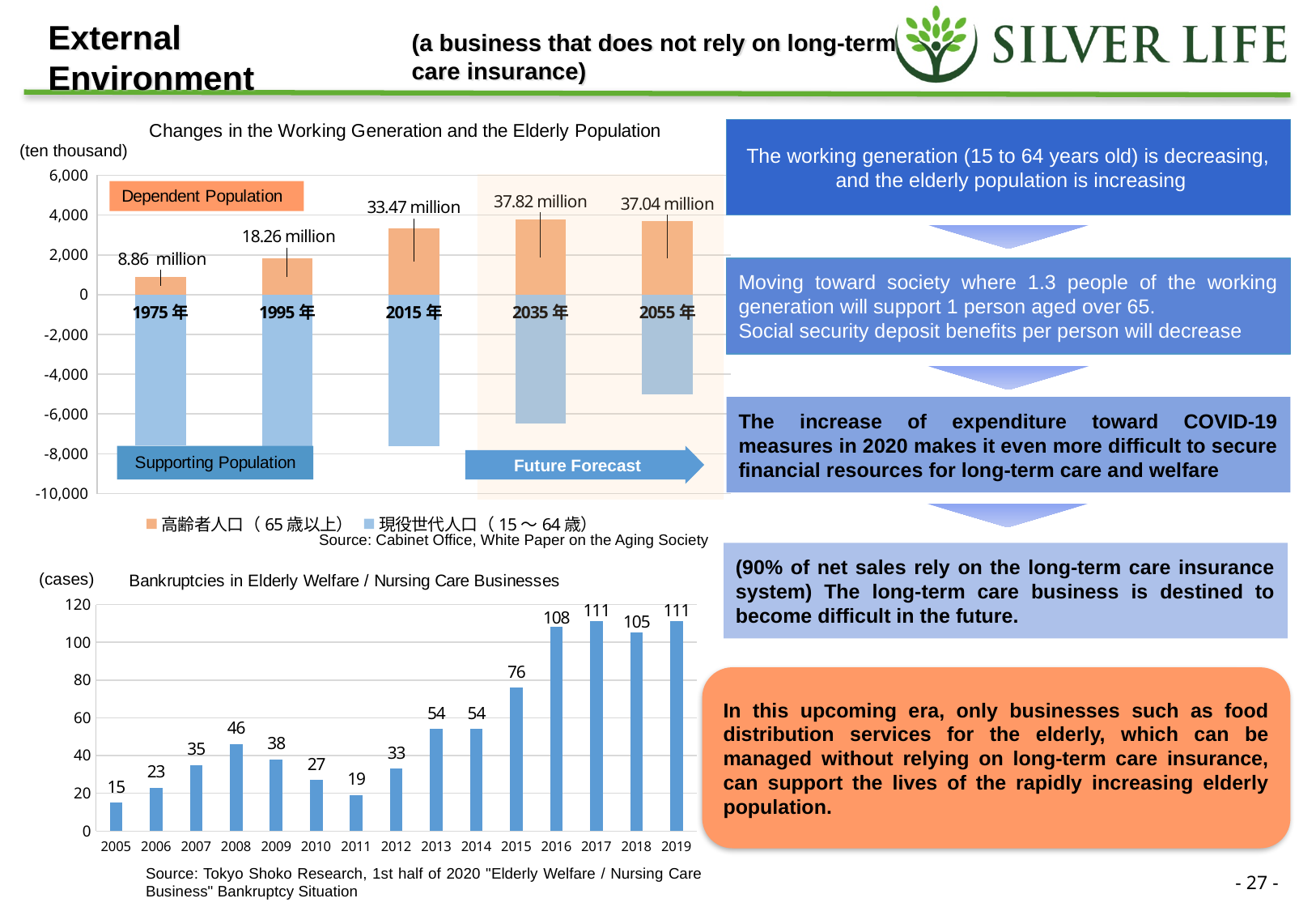
In the 'Bankruptcies in Elderly Welfare / Nursing Care Businesses' chart, what is the value for 2005? 15 In the 'Bankruptcies in Elderly Welfare / Nursing Care Businesses' chart, do the values generally rise or fall from 2011 to 2017? rise In the 'Bankruptcies in Elderly Welfare / Nursing Care Businesses' chart, which is larger, the value for 2008 or the value for 2010? 2008 In the 'Bankruptcies in Elderly Welfare / Nursing Care Businesses' chart, which year has the lowest number of cases? 2005 In the 'Changes in the Working Generation and the Elderly Population' chart, what is the dependent population label for 1975? 8.86 million In the 'Changes in the Working Generation and the Elderly Population' chart, what is the dependent population label for 2015? 33.47 million In the 'Changes in the Working Generation and the Elderly Population' chart, is the supporting population bar for 2015 below -6,000? yes In the 'Bankruptcies in Elderly Welfare / Nursing Care Businesses' chart, what is the difference between the 2016 and 2015 values? 32 In the 'Changes in the Working Generation and the Elderly Population' chart, which year has the highest labelled dependent population? 2035 In the 'Bankruptcies in Elderly Welfare / Nursing Care Businesses' chart, how many bankruptcy cases were there in 2015? 76 What kind of chart is the 'Bankruptcies in Elderly Welfare / Nursing Care Businesses' chart? bar chart In the 'Bankruptcies in Elderly Welfare / Nursing Care Businesses' chart, how many years are shown on the x axis? 15